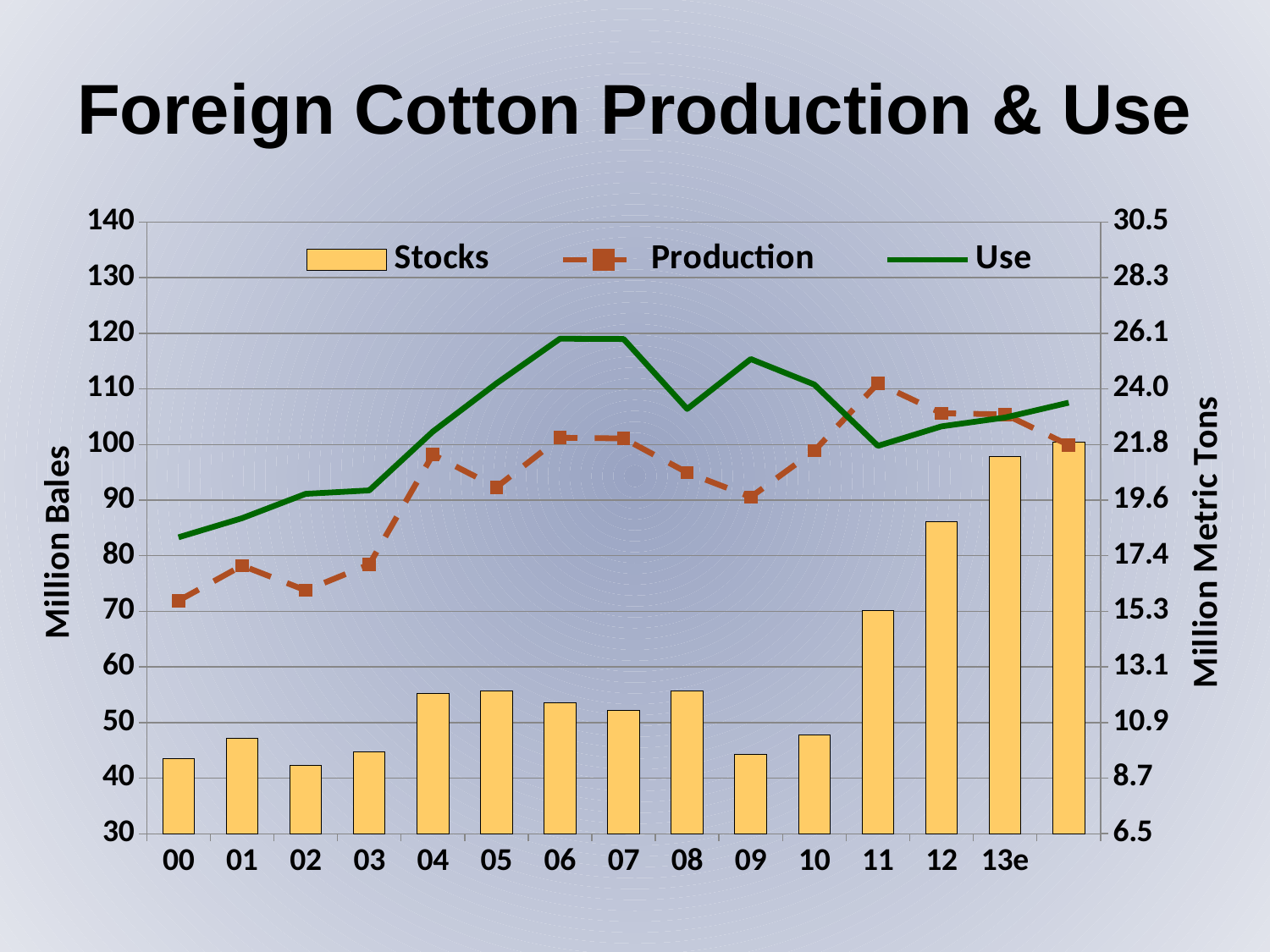
In which year is the Use line at its lowest? 00 Is the Use value for 06 greater or less than 110 on the left axis? greater In 11, which is higher, Production or Use? Production Which series is drawn as bars? Stocks In which year is the Production line at its highest? 11 Is the Stocks value for 12 greater or less than 80 million bales? greater Is the Stocks value for 09 greater or less than 50 million bales? less What is the title of the left vertical axis? Million Bales How do the Stocks bars change from 10 through 13e? They rise In which year is the Production line at its lowest? 00 What kind of chart is shown on the slide? A combination bar and line chart How many series does the legend list? 3